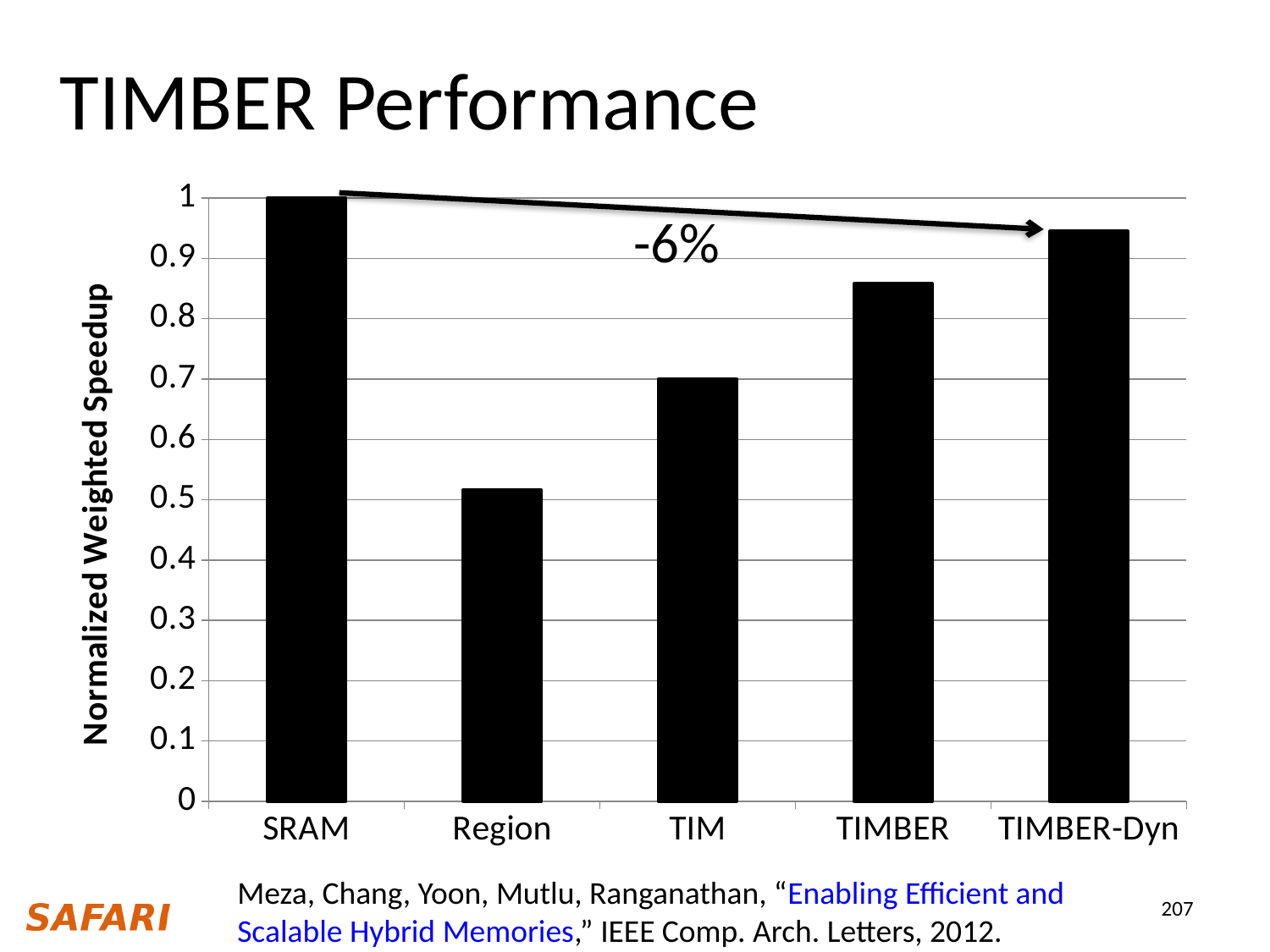
Is the value for TIMBER greater or less than 0.8? greater Is the value for TIMBER-Dyn greater or less than 0.9? greater What is the normalized weighted speedup for SRAM? 1 What is the label on the y axis of the chart? Normalized Weighted Speedup Which has a higher normalized weighted speedup, Region or TIM? TIM Which category has the lowest normalized weighted speedup? Region How many categories are shown on the x axis of the chart? 5 Which has a higher normalized weighted speedup, TIM or TIMBER? TIMBER Which category has the highest normalized weighted speedup? SRAM What kind of chart is shown on the slide? bar chart Is the value for TIM greater or less than 0.6? greater